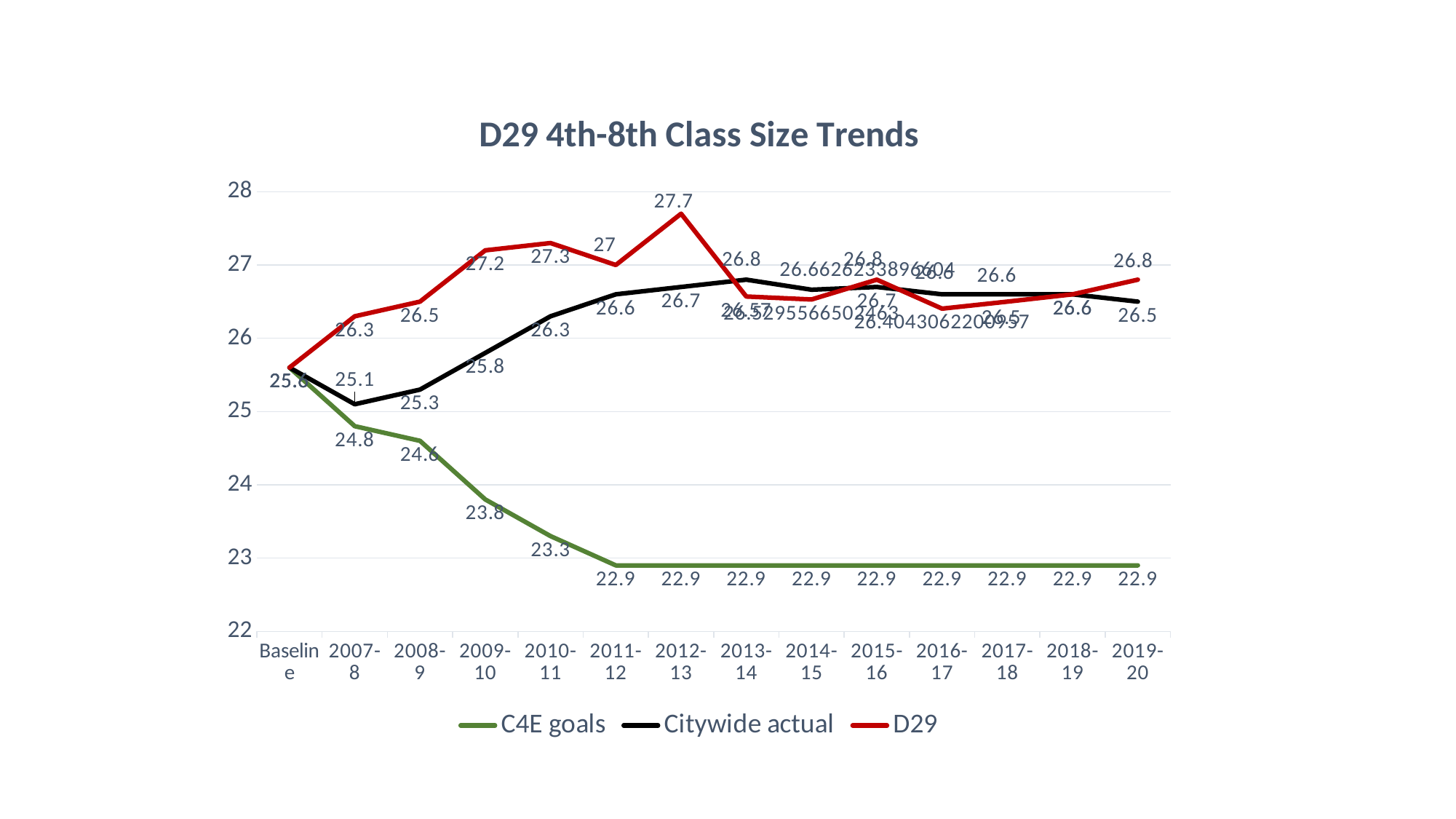
What is the C4E goals value for 2010-11? 23.3 Which is larger in 2009-10, the D29 value or the Citywide actual value? D29 What is the difference between the D29 value and the Citywide actual value in 2012-13? 1 How many series does the legend list? 3 In which year does the D29 series reach its highest value? 2012-13 What is the title of the chart? D29 4th-8th Class Size Trends What kind of chart is shown on the slide? line chart What is the Citywide actual value for 2007-8? 25.1 What is the D29 value for 2012-13? 27.7 How many categories are shown along the x axis? 14 Do the C4E goals values rise or fall from Baseline to 2011-12? fall In which year is the Citywide actual series at its lowest value? 2007-8